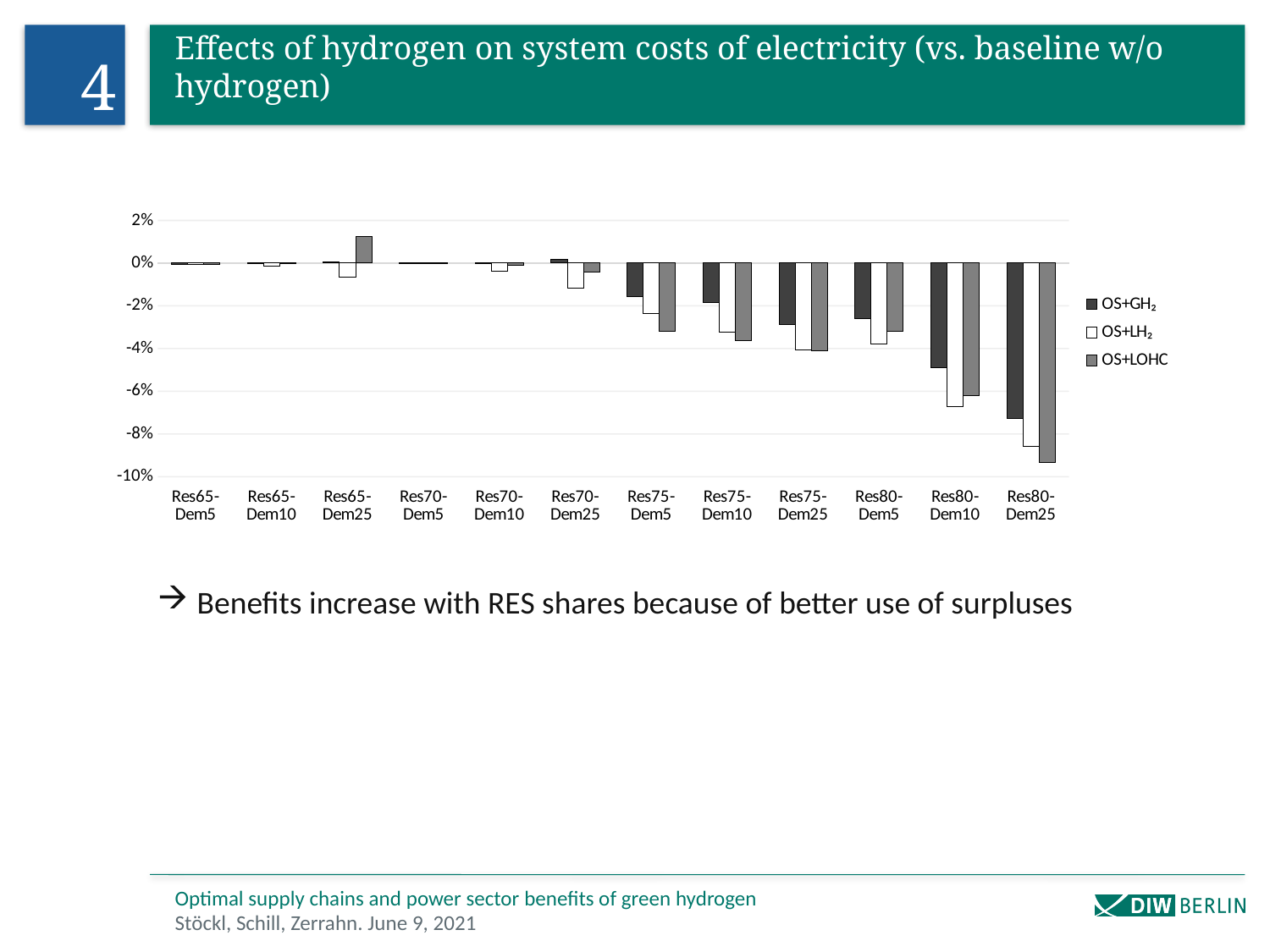
Which category has the lowest (most negative) value in the chart? Res80-Dem25 What kind of chart is shown on the slide? bar chart How many series does the chart legend list? 3 Is the OS+LH₂ value for Res80-Dem10 greater or less than -6%? less Is the OS+LOHC value for Res80-Dem25 higher or lower than the OS+LOHC value for Res80-Dem10? lower What is the title of the chart slide? Effects of hydrogen on system costs of electricity (vs. baseline w/o hydrogen) Which series is shown with white (unfilled) bars in the chart? OS+LH₂ How many categories (scenarios) are shown on the x axis of the chart? 12 Do the values generally rise or fall moving from left to right along the x axis? fall Is the OS+GH₂ value for Res80-Dem10 greater or less than -4%? less Is the OS+LOHC value for Res80-Dem25 greater or less than -8%? less